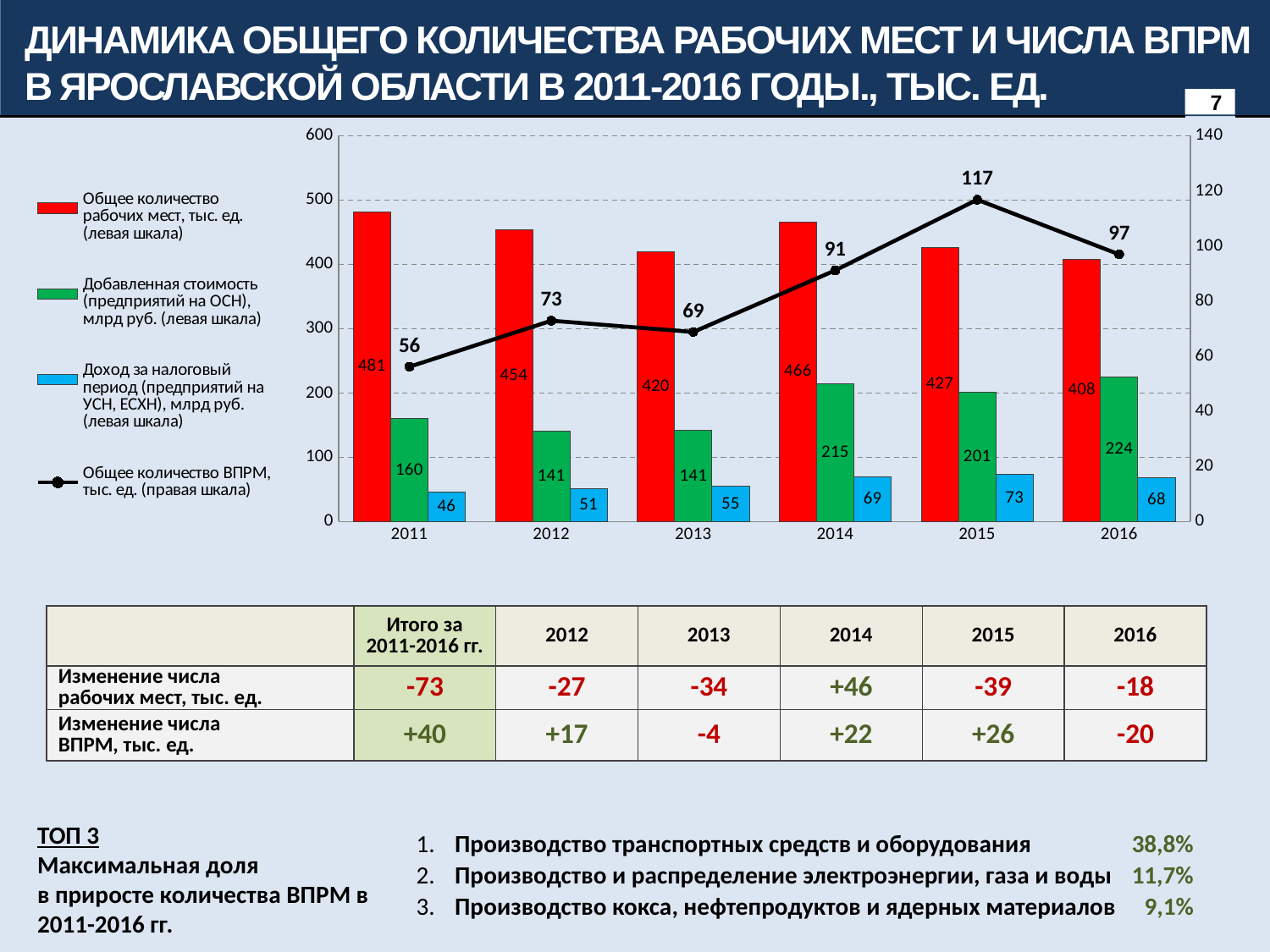
What is the value of the red bar (Общее количество рабочих мест) for 2011? 481 Is the red bar value for 2013 greater or less than 400 on the left axis? greater Does the blue bar series (Доход за налоговый период) rise or fall from 2011 to 2015? rise What is the value of the blue bar (Доход за налоговый период) for 2013? 55 How many series does the chart legend list? 4 How many years are shown on the x axis of the chart? 6 What is the difference between the red bar values for 2011 and 2016? 73 In which year does the line (Общее количество ВПРМ) reach its highest value? 2015 What is the value of the green bar (Добавленная стоимость) for 2016? 224 Which is larger: the green bar for 2014 or the green bar for 2015? 2014 What is the value of the line (Общее количество ВПРМ) for 2015? 117 In which year is the red bar (Общее количество рабочих мест) lowest? 2016